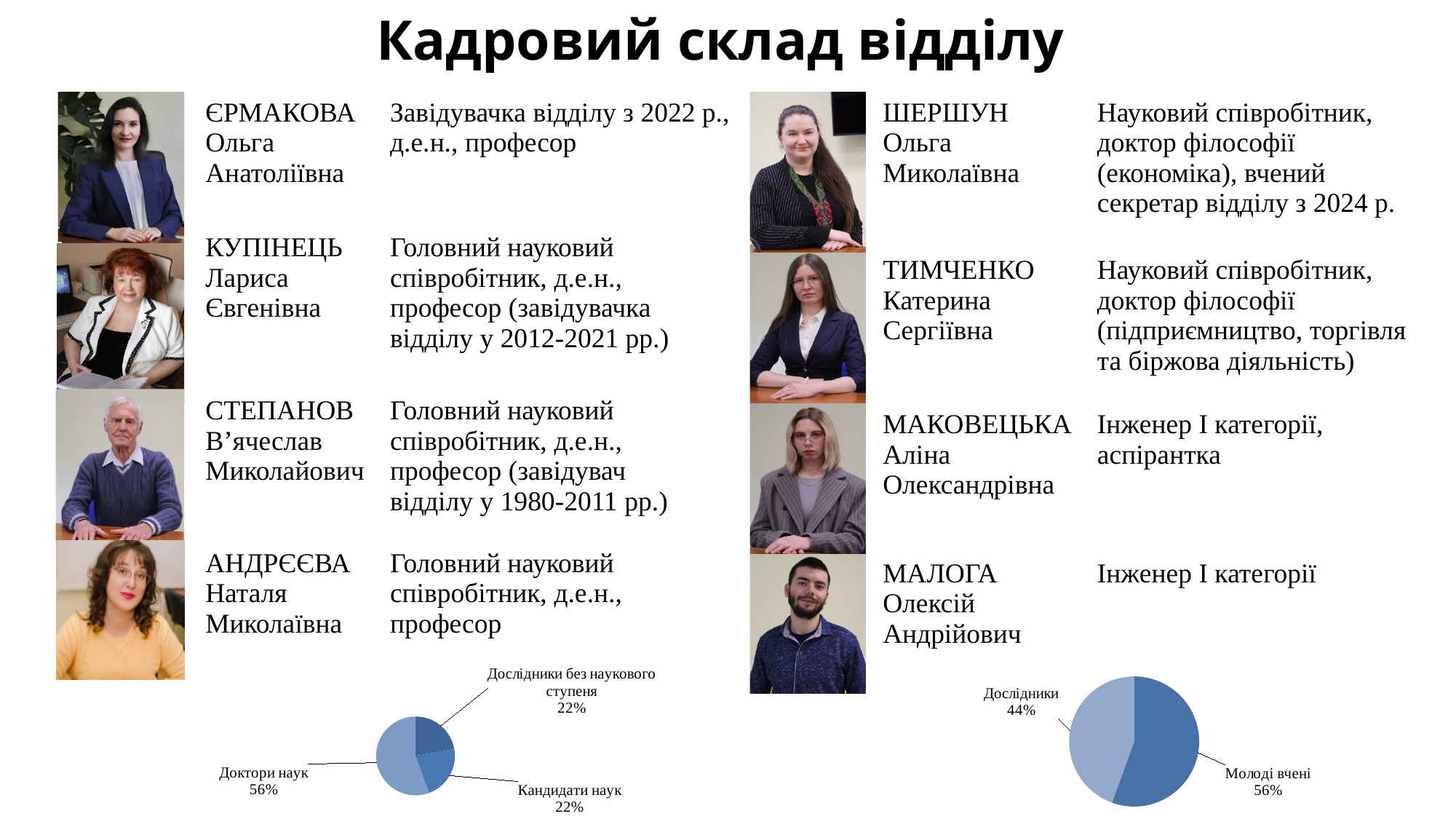
In the bottom-right pie chart, what share is labelled for Дослідники? 44% In the bottom-left pie chart, which slice is the largest? Доктори наук In the bottom-right pie chart, which slice is larger, Дослідники or Молоді вчені? Молоді вчені In the bottom-left pie chart, what share is labelled for Дослідники без наукового ступеня? 22% What kind of chart is the bottom-left chart on the slide? Pie chart In the bottom-left pie chart, what share is labelled for Кандидати наук? 22% In the bottom-left pie chart, what is the difference between the share for Доктори наук and the share for Кандидати наук? 34% How many slices does the bottom-right pie chart have? 2 In the bottom-right pie chart, what is the difference between the share for Молоді вчені and the share for Дослідники? 12% How many slices does the bottom-left pie chart have? 3